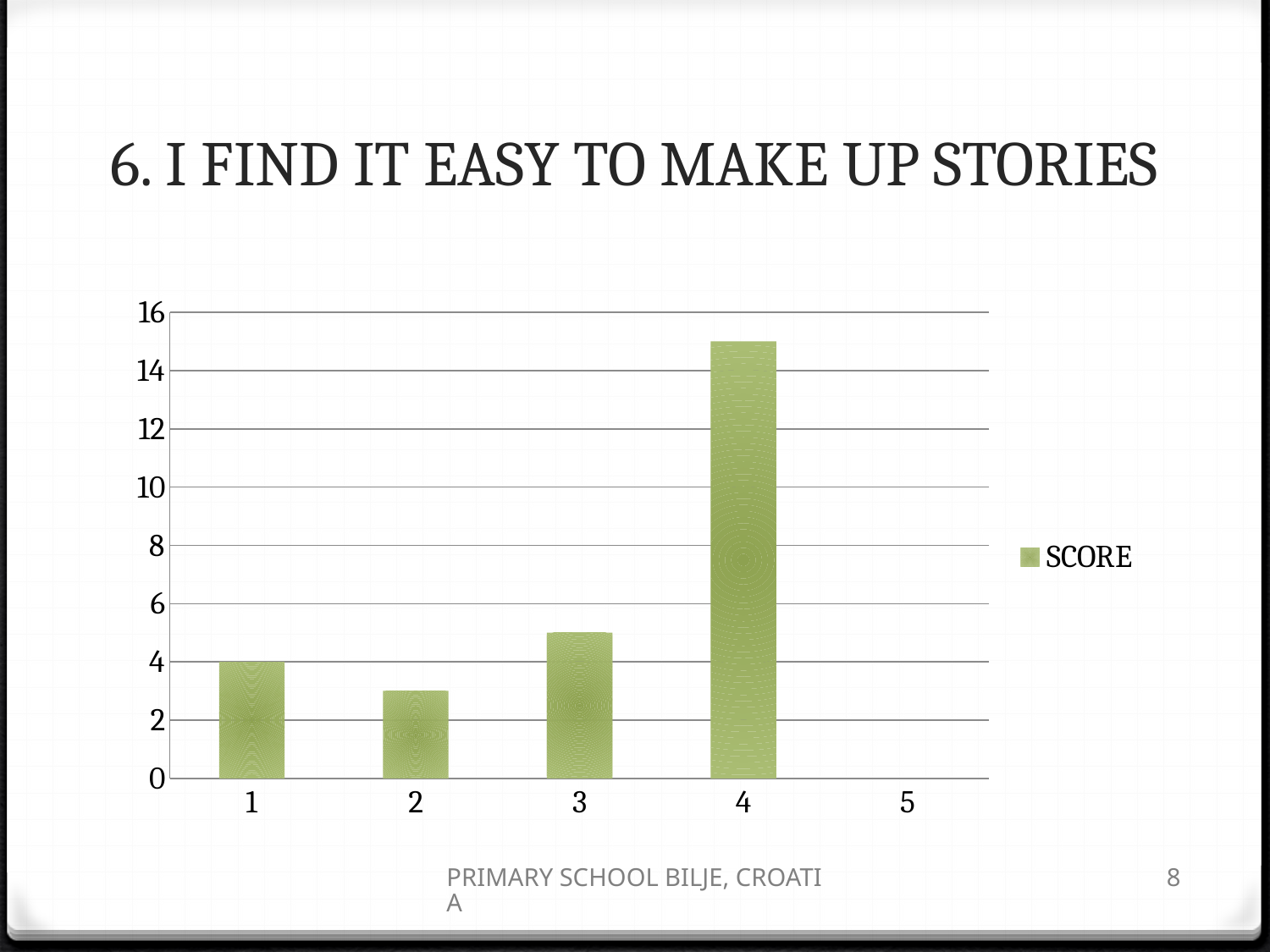
Is the SCORE for category 3 greater or less than 4? greater Is the SCORE for category 2 greater or less than 4? less Which has a larger SCORE, category 1 or category 4? category 4 What is the name of the series shown in the legend? SCORE What is the SCORE value for category 1? 4 How many series does the legend list? 1 Which has a larger SCORE, category 3 or category 2? category 3 Which category has the highest SCORE? 4 How many categories are shown on the x axis? 5 Is the SCORE for category 4 greater or less than 14? greater Among the categories with a visible bar, which has the lowest SCORE? 2 What kind of chart is shown on the slide? bar chart